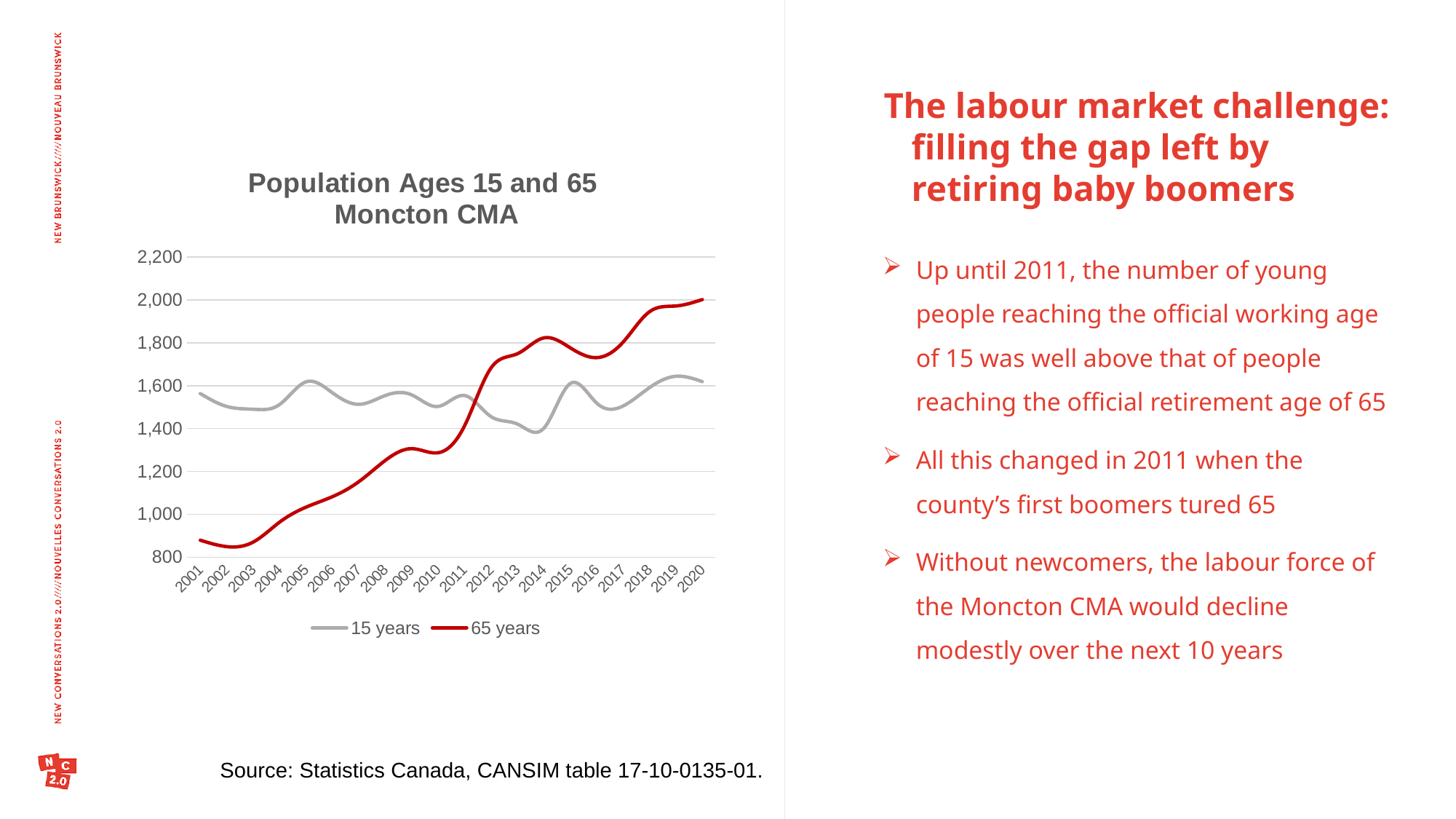
In 2013, which series has the larger value, 15 years or 65 years? 65 years In 2001, which series has the larger value, 15 years or 65 years? 15 years In 2020, which series has the larger value, 15 years or 65 years? 65 years Is the value for 65 years in 2020 greater or less than 1,800? greater Which series is drawn in red? 65 years Does the 65 years series rise or fall overall from 2001 to 2020? rise In which year does the 65 years series reach its highest value? 2020 How many series does the legend list? 2 What type of chart is shown on the slide? line chart How many years are plotted along the x axis? 20 Is the value for 65 years in 2001 greater or less than 1,000? less What is the title of the chart? Population Ages 15 and 65 Moncton CMA